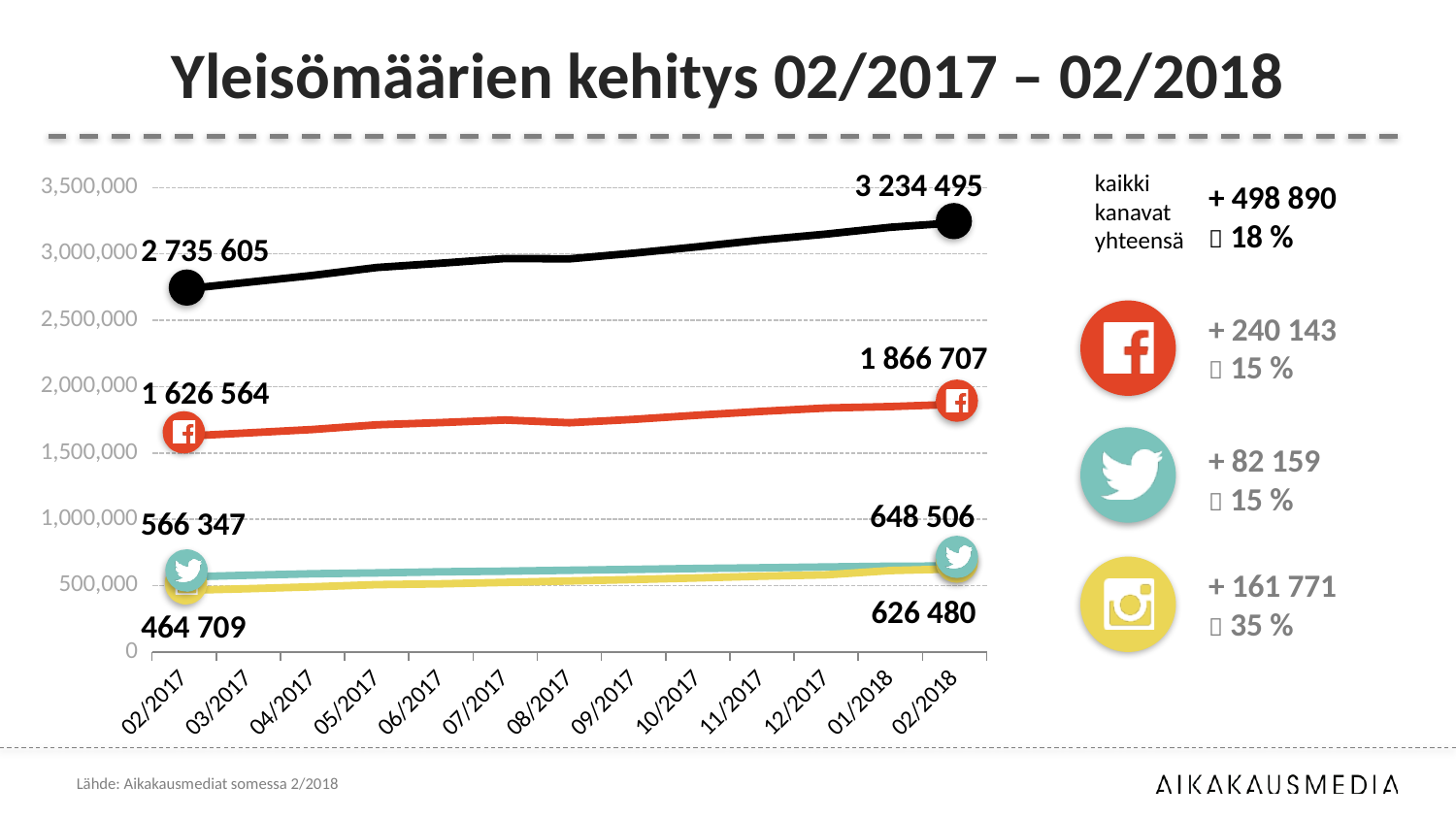
Which line has the highest value at 02/2018? the black total line (kaikki kanavat yhteensä) Do the lines rise or fall from 02/2017 to 02/2018? rise What is the value of the Facebook line at 02/2018? 1 866 707 By how much did the Facebook line increase from 02/2017 to 02/2018? 240 143 At 02/2018, which is larger: the Twitter value or the Instagram value? Twitter What percentage growth is shown next to the Instagram icon on the right of the slide? 35 % How many months are shown on the x axis? 13 What is the value of the black total line (kaikki kanavat yhteensä) at 02/2017? 2 735 605 What is the value of the Twitter line at 02/2017? 566 347 Is the value of the Facebook line at 08/2017 greater or less than 2,000,000? less What kind of chart is shown on the slide? line chart What is the value of the Instagram line at 02/2018? 626 480